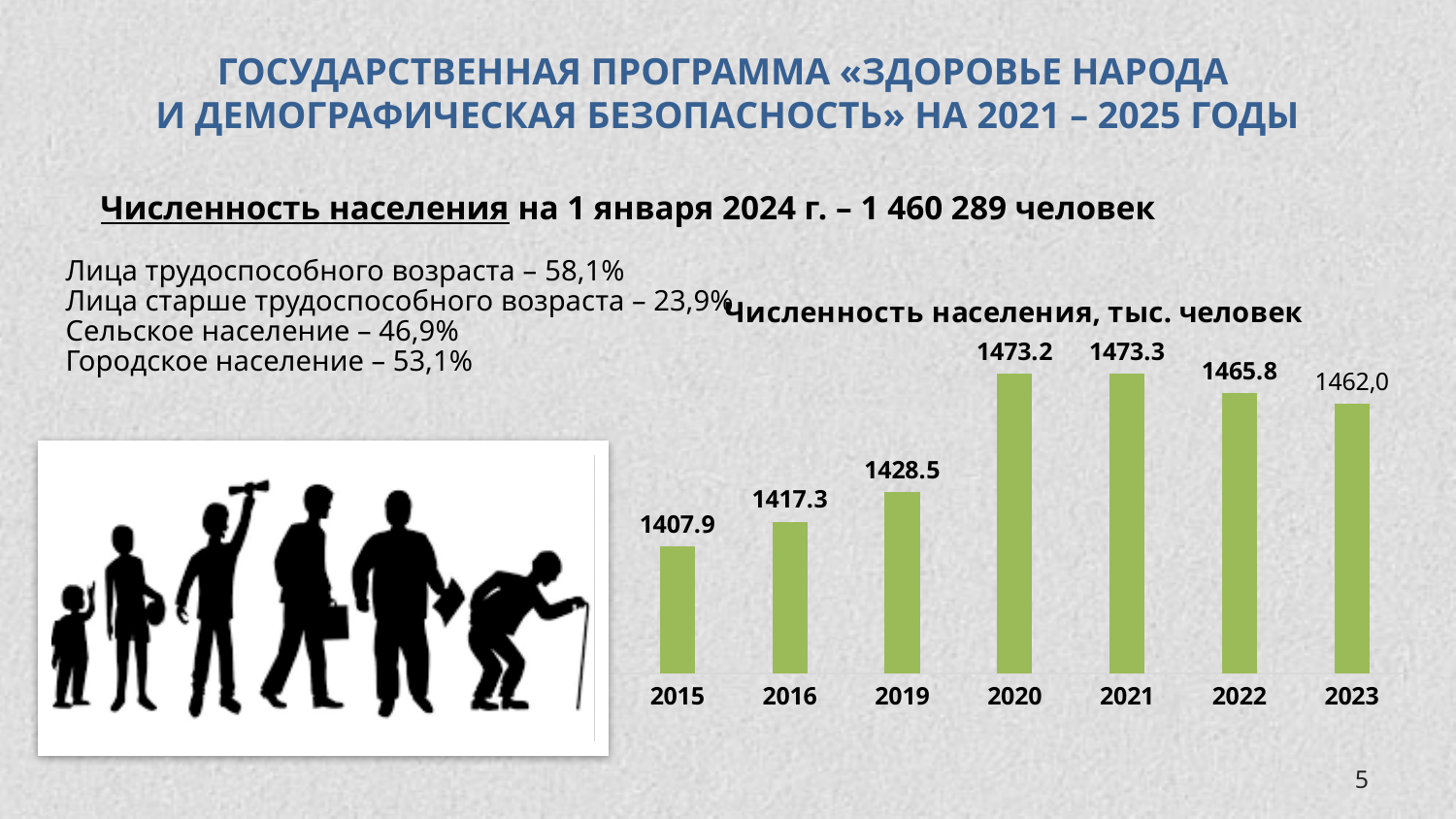
Which year has a larger population value in the chart, 2019 or 2022? 2022 What is the difference between the population values for 2020 and 2019 in the chart? 44.7 What type of chart is used to show the population by year? Bar chart What is the population value shown for 2015 in the chart "Численность населения, тыс. человек"? 1407.9 What is the difference between the population values for 2023 and 2015 in the chart? 54.1 What is the population value shown for 2020 in the chart? 1473.2 How many years (bars) are shown in the chart? 7 Which year has the highest population value according to the data labels in the chart? 2021 What is the title of the chart on the slide? Численность населения, тыс. человек What is the population value shown for 2023 in the chart? 1462,0 Which year has the lowest population value in the chart? 2015 What is the population value shown for 2019 in the chart? 1428.5